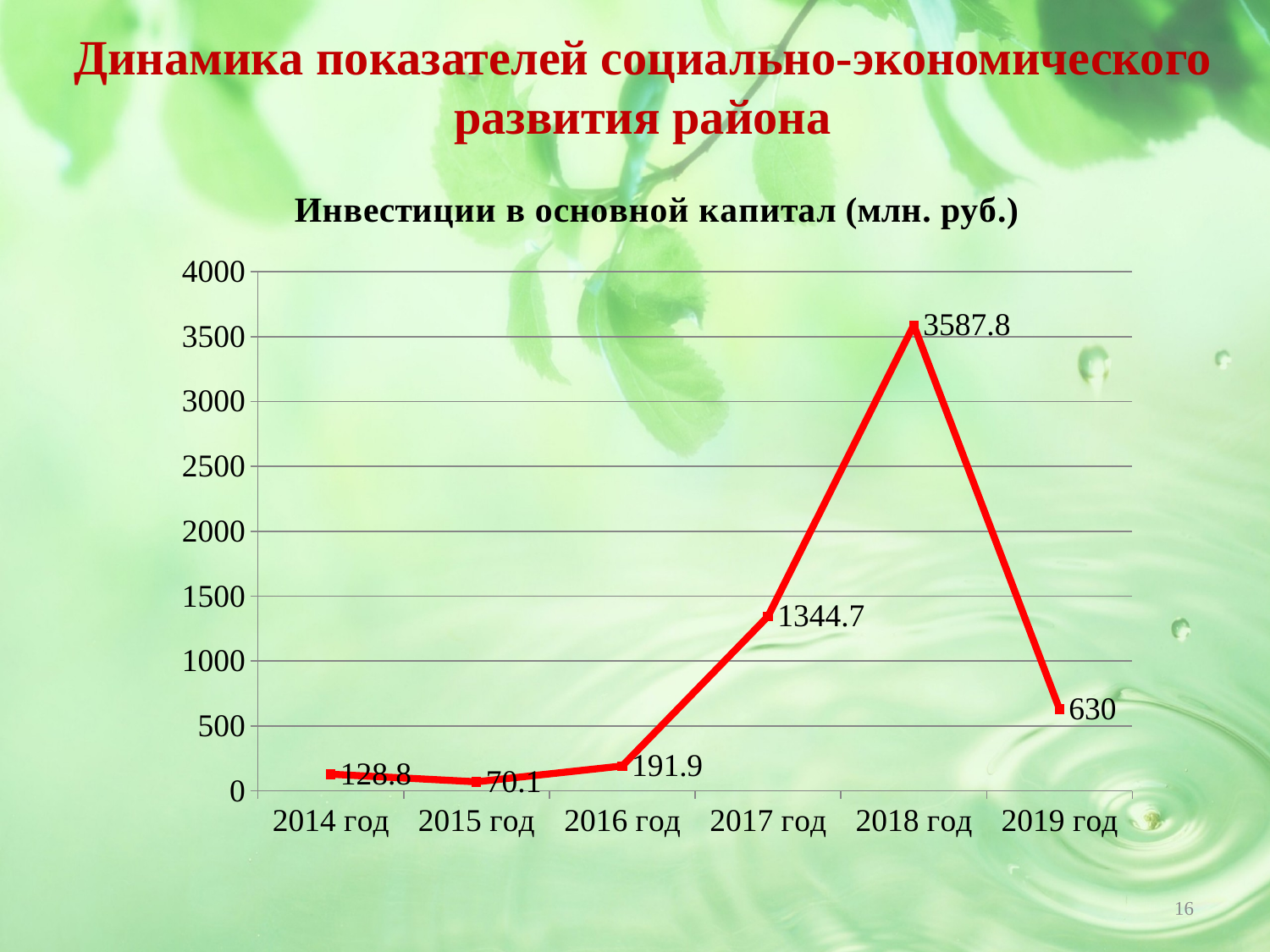
What is the title of the chart? Инвестиции в основной капитал (млн. руб.) How many years are plotted on the x axis? 6 What type of chart is shown on the slide? line chart What is the difference between the values for 2018 год and 2017 год? 2243.1 Which year has the highest value? 2018 год Is the value for 2017 год greater or less than 1000? greater What is the value for 2019 год? 630 What is the value for 2015 год? 70.1 Which year has the lowest value? 2015 год Does the value rise or fall from 2018 год to 2019 год? fall Which is larger, the value for 2016 год or the value for 2014 год? 2016 год What is the value for 2018 год? 3587.8